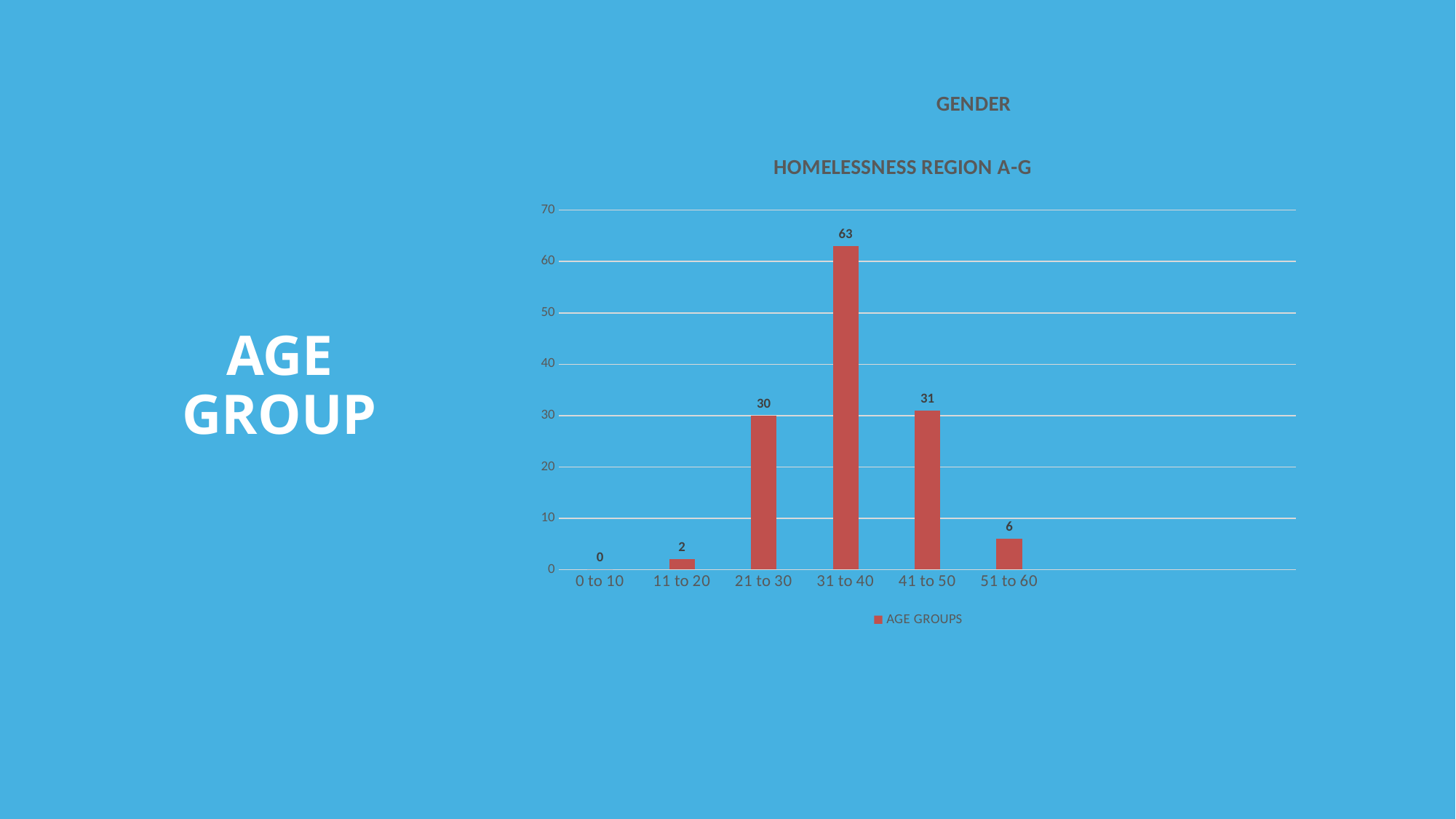
How many series does the legend list? 1 What is the difference between the values for 31 to 40 and 41 to 50? 32 What is the value for the 31 to 40 age group? 63 Which is larger, the value for 21 to 30 or the value for 51 to 60? 21 to 30 Is the value for 41 to 50 greater or less than 20? greater What kind of chart is shown on the slide? bar chart Which age group has the highest value? 31 to 40 How many age group categories are shown on the x axis? 6 What is the value for the 11 to 20 age group? 2 Which age group has the lowest value? 0 to 10 What is the value for the 51 to 60 age group? 6 What is the legend entry for the series in the chart? AGE GROUPS